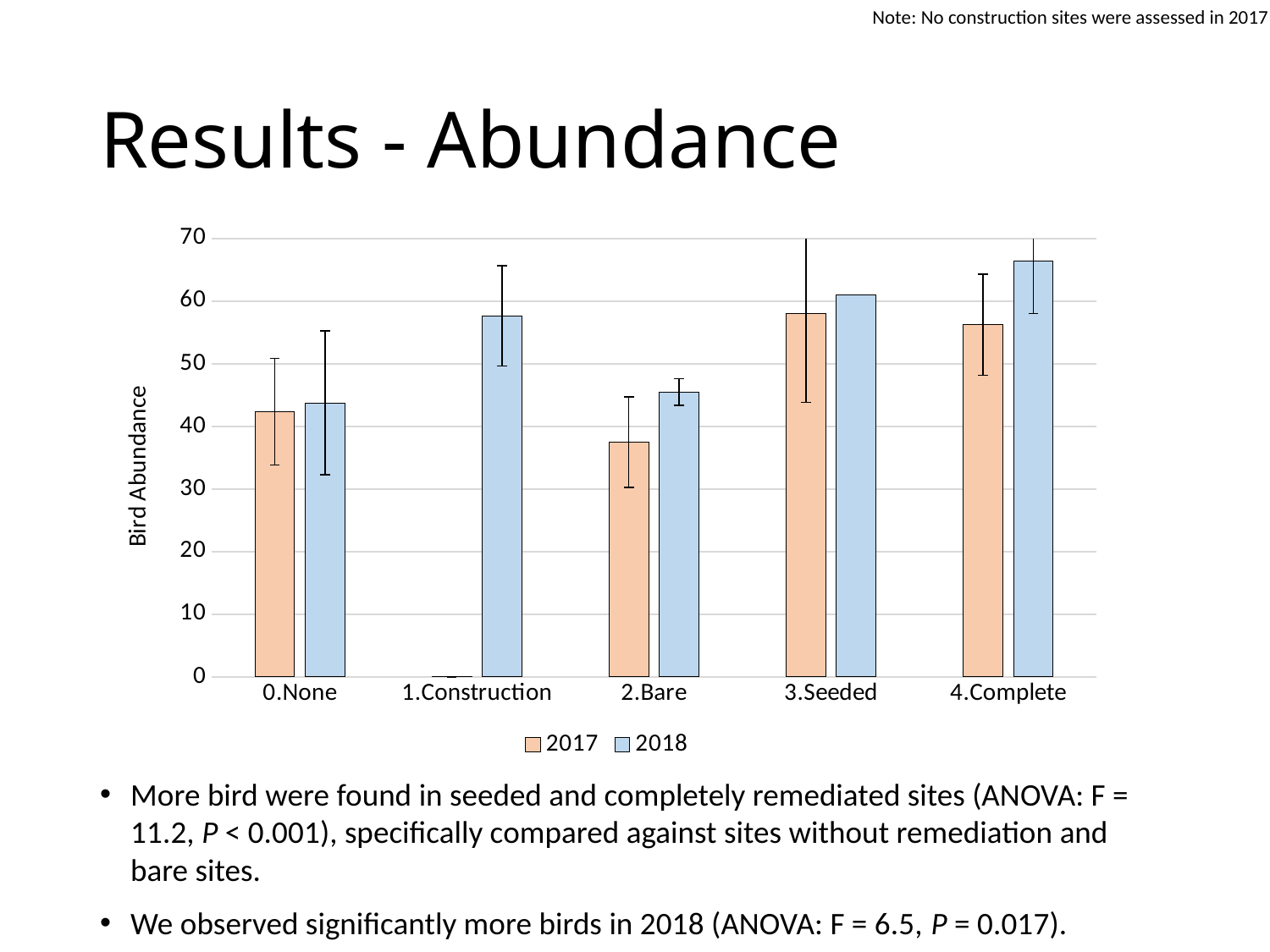
Which category has the highest 2018 bird abundance? 4.Complete Is the 2017 value for 2.Bare greater or less than 40? less For 2017, which is larger: 4.Complete or 0.None? 4.Complete What kind of chart is shown on the slide? bar chart For 2018, which is larger: 3.Seeded or 2.Bare? 3.Seeded For 2.Bare, which year has the larger bird abundance, 2017 or 2018? 2018 How many site categories are shown on the x axis? 5 Is the 2018 value for 2.Bare greater or less than 50? less How many series does the legend list? 2 Is the 2018 value for 4.Complete greater or less than 60? greater What is the label of the vertical axis? Bird Abundance